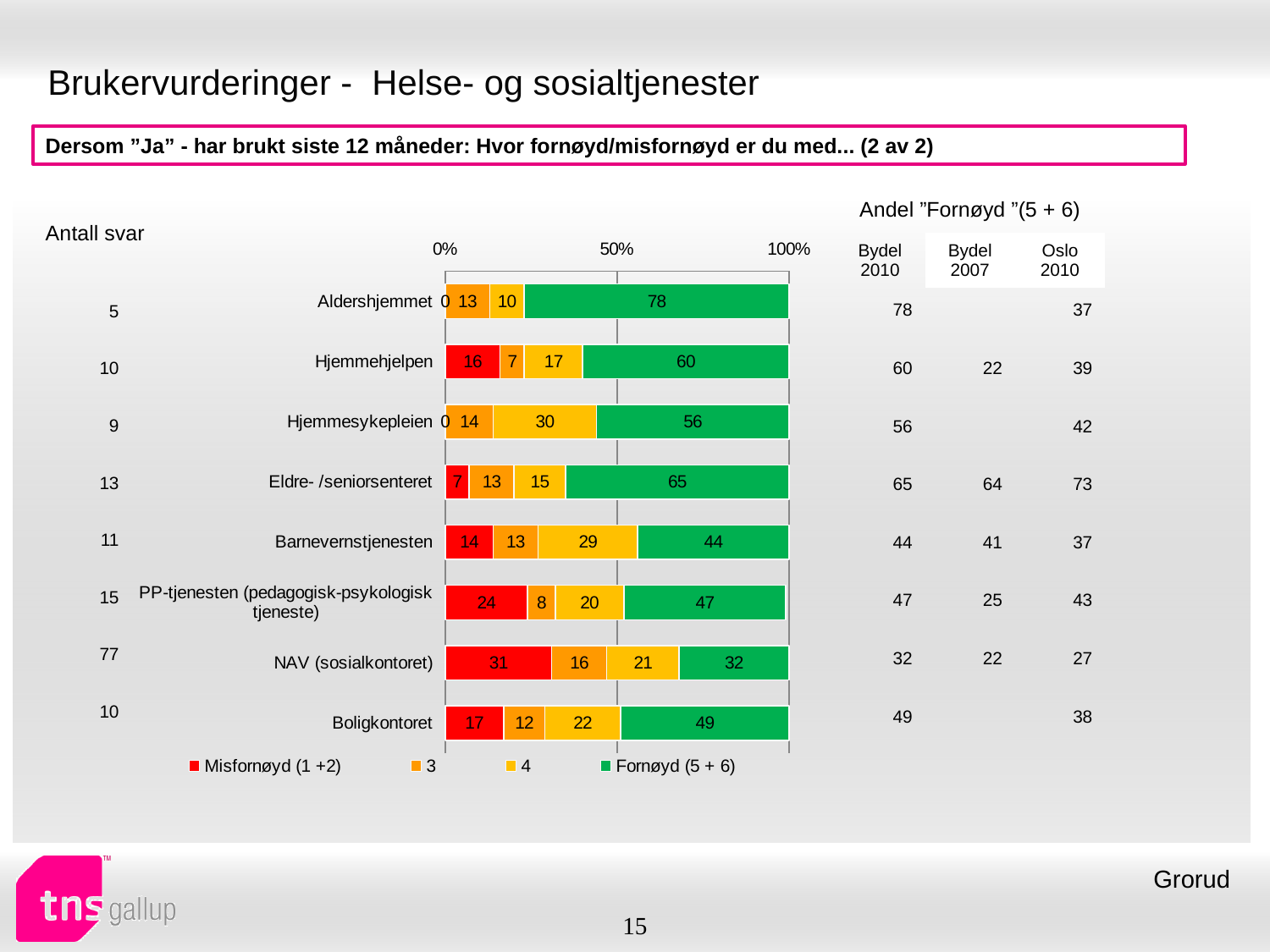
How many series does the legend list? 4 Which category has the highest Misfornøyd (1 +2) value? NAV (sosialkontoret) What is the value of the Fornøyd (5 + 6) series for Aldershjemmet? 78 What is the value of the series '3' for Barnevernstjenesten? 13 What is the difference between the Fornøyd (5 + 6) values for Aldershjemmet and NAV (sosialkontoret)? 46 What is the value of the Misfornøyd (1 +2) series for NAV (sosialkontoret)? 31 What kind of chart is shown on the slide? Stacked bar chart Which has a larger Fornøyd (5 + 6) value, Hjemmehjelpen or Hjemmesykepleien? Hjemmehjelpen Which category has the lowest Fornøyd (5 + 6) value? NAV (sosialkontoret) How many categories are shown in the chart? 8 Which category has the highest Fornøyd (5 + 6) value? Aldershjemmet What is the value of the series '4' for Hjemmesykepleien? 30